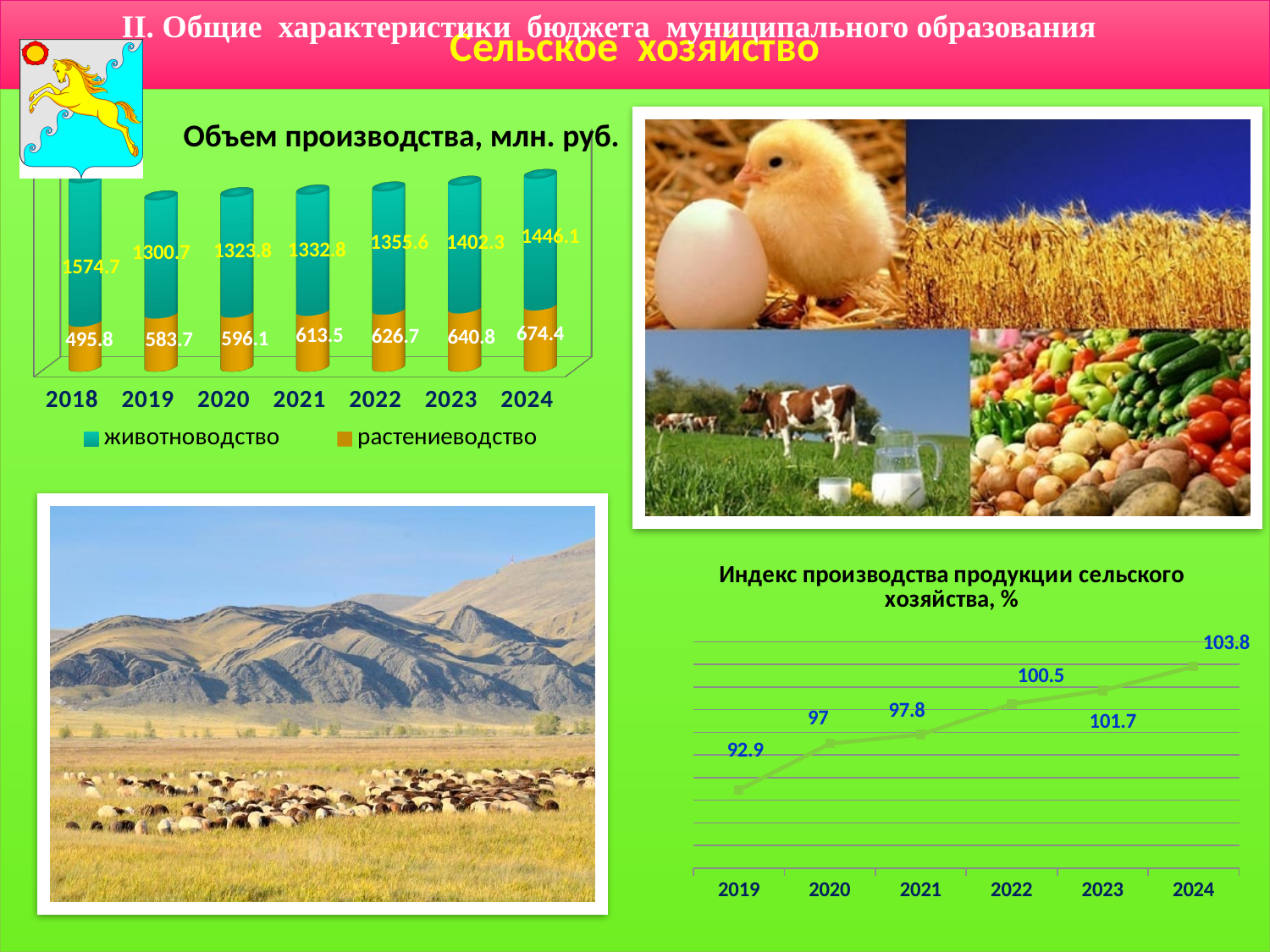
In the chart 'Объем производства, млн. руб.', which year has the lowest value for растениеводство? 2018 In the chart 'Индекс производства продукции сельского хозяйства, %', what is the value for 2022? 100.5 In the chart 'Объем производства, млн. руб.', what is the total of the stacked bar for 2024? 2120.5 In the chart 'Объем производства, млн. руб.', what is the difference between the растениеводство values for 2024 and 2018? 178.6 In the chart 'Объем производства, млн. руб.', how many years are shown on the x axis? 7 In the chart 'Объем производства, млн. руб.', what is the value for животноводство in 2024? 1446.1 In the chart 'Объем производства, млн. руб.', how many series does the legend list? 2 In the chart 'Индекс производства продукции сельского хозяйства, %', what is the difference between the values for 2024 and 2019? 10.9 What kind of chart is 'Индекс производства продукции сельского хозяйства, %'? line chart In the chart 'Объем производства, млн. руб.', which year has the highest value for животноводство? 2018 In the chart 'Объем производства, млн. руб.', what is the value for растениеводство in 2021? 613.5 In the chart 'Индекс производства продукции сельского хозяйства, %', do the values rise or fall from 2019 to 2024? rise